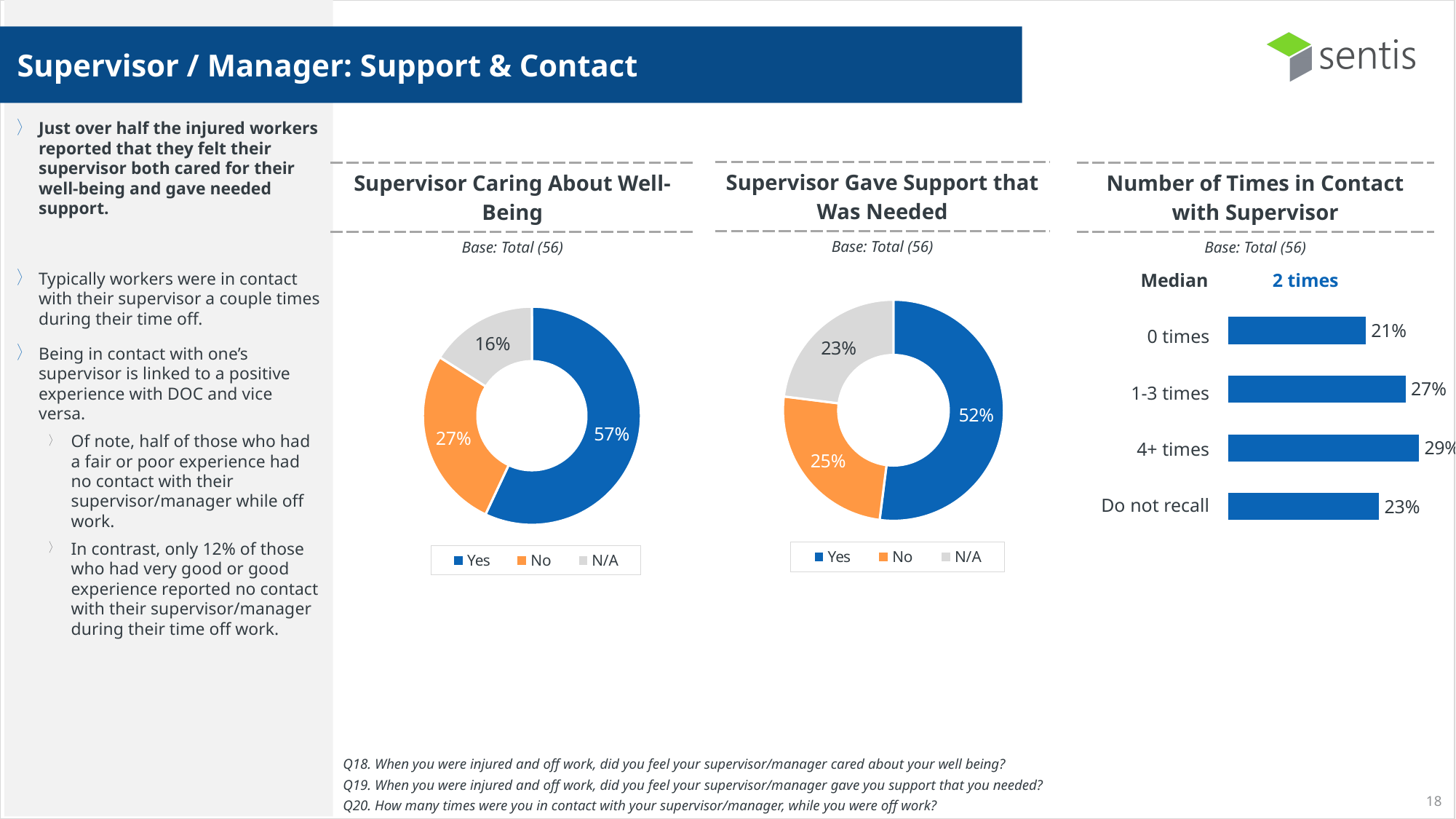
In the 'Supervisor Caring About Well-Being' chart, what percentage answered Yes? 57% In the 'Number of Times in Contact with Supervisor' chart, which category has the highest value? 4+ times In the 'Number of Times in Contact with Supervisor' chart, what is the value for '1-3 times'? 27% What kind of chart is the 'Number of Times in Contact with Supervisor' chart? Bar chart What median value is shown above the 'Number of Times in Contact with Supervisor' chart? 2 times In the 'Supervisor Gave Support that Was Needed' chart, which is larger: the No share or the N/A share? No In the 'Supervisor Caring About Well-Being' chart, what is the difference between the Yes and No percentages? 30% In the 'Supervisor Gave Support that Was Needed' chart, what percentage answered No? 25% How many categories are shown in the 'Number of Times in Contact with Supervisor' chart? 4 In the 'Number of Times in Contact with Supervisor' chart, which category has the lowest value? 0 times What kind of chart is the 'Supervisor Gave Support that Was Needed' chart? Doughnut chart How many entries does the legend of the 'Supervisor Caring About Well-Being' chart list? 3